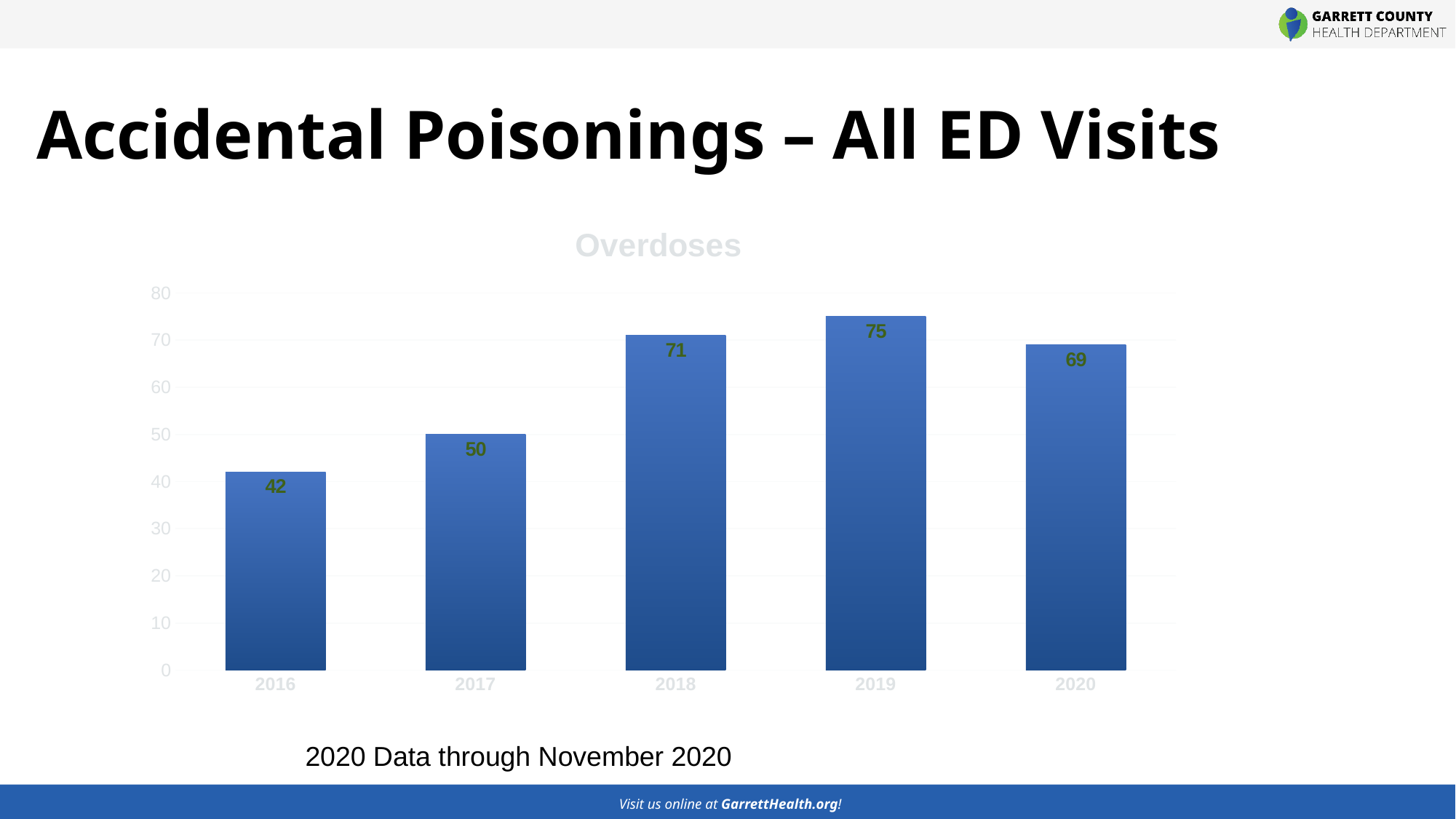
What is the difference between the values for 2018 and 2017? 21 How many years are shown on the x axis? 5 Which is larger, the value for 2017 or the value for 2020? 2020 What kind of chart is shown on the slide? bar chart What is the title of the chart? Overdoses Is the value for 2019 greater or less than 70? greater What is the value for 2020? 69 Which year has the lowest value? 2016 What is the value for 2016? 42 Which year has the highest value? 2019 What is the value for 2018? 71 What is the difference between the values for 2019 and 2016? 33